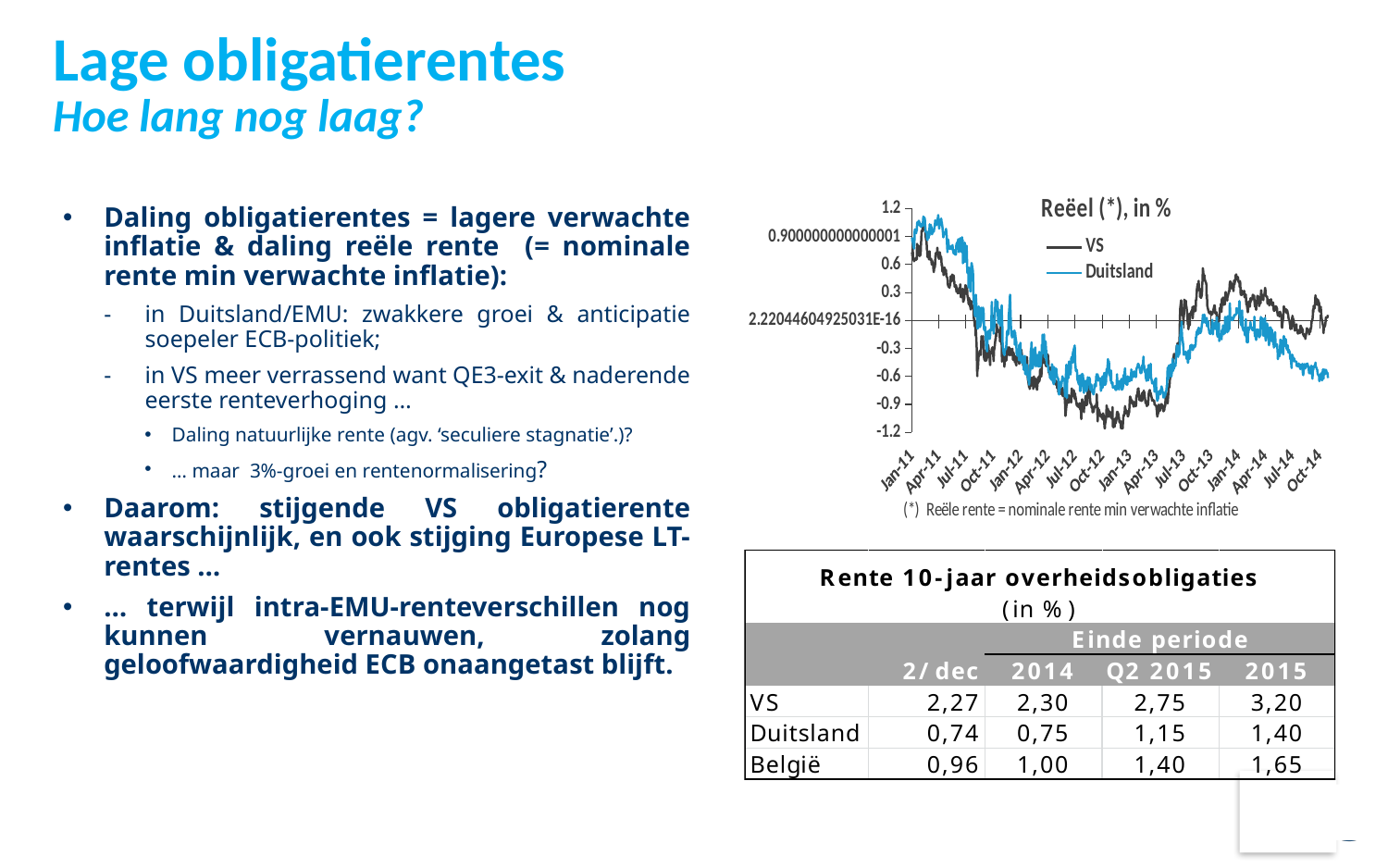
Is the value for VS at Oct-13 greater or less than 0? greater Is the value for VS at Jan-13 greater or less than -0.6? less Is the value for VS at Jan-11 greater or less than 0.6? greater Which two series are listed in the chart's legend? VS and Duitsland What is the title of the chart? Reëel (*), in % How many series does the legend of the chart list? 2 At Oct-14, which series has the higher value, VS or Duitsland? VS What kind of chart is shown on the slide? line chart How many date labels are shown on the x axis of the chart? 16 At Jan-13, which series has the higher value, VS or Duitsland? Duitsland Does the VS series rise or fall between Jan-11 and Jan-13? fall